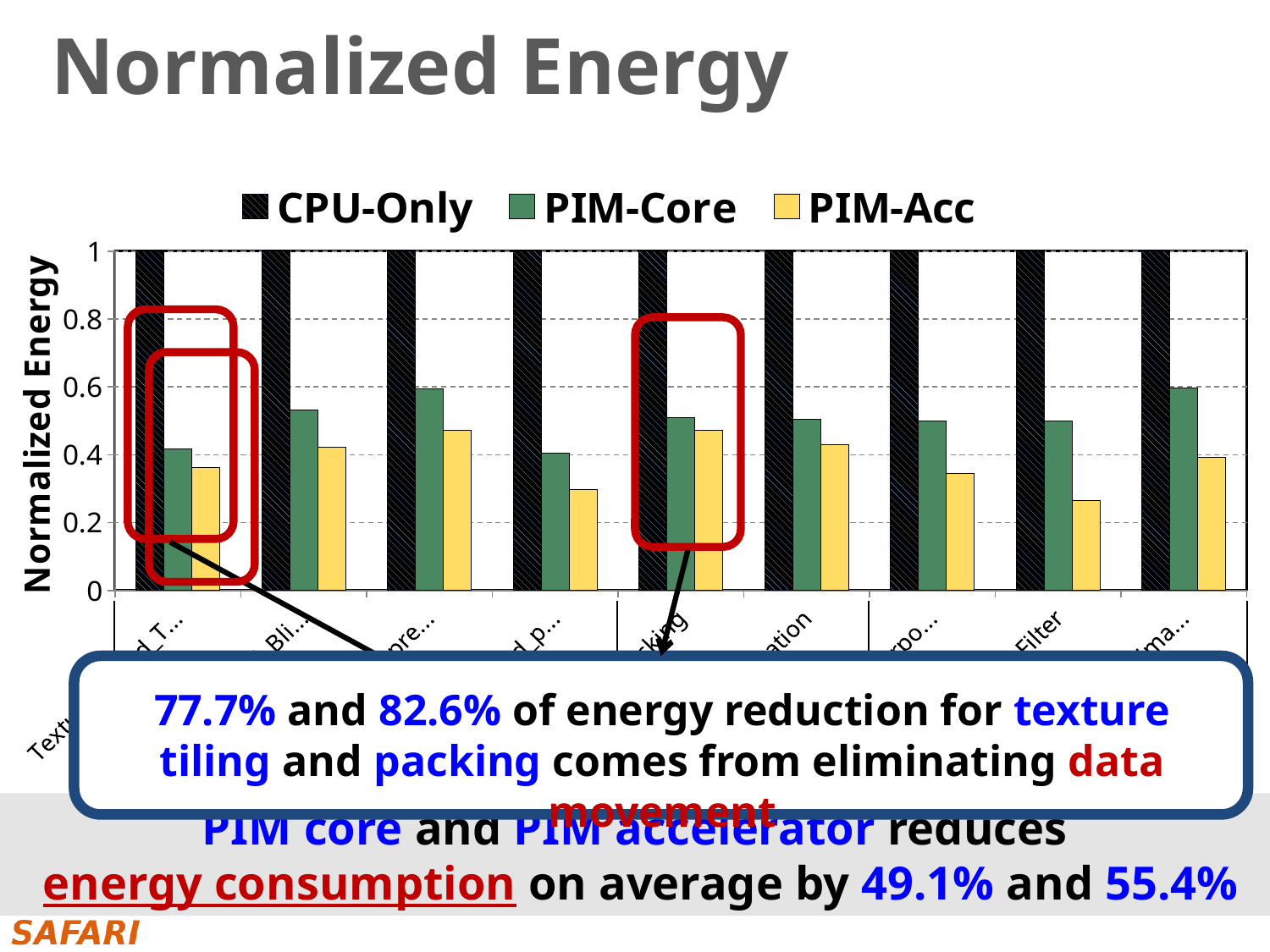
Which series has the lowest value for the Filter category? PIM-Acc What kind of chart is shown on the slide? bar chart What is the label on the y axis? Normalized Energy Is the PIM-Core value for Filter greater or less than 0.4? greater For the Filter category, which is larger: PIM-Core or PIM-Acc? PIM-Core Is the PIM-Acc value for Filter greater or less than 0.4? less Is the PIM-Acc value for Filter greater or less than 0.2? greater Which series has the highest value in every category? CPU-Only What is the CPU-Only value for the Filter category? 1 What are the three series named in the legend? CPU-Only, PIM-Core, PIM-Acc How many series does the legend list? 3 How many category groups are plotted along the x axis? 9